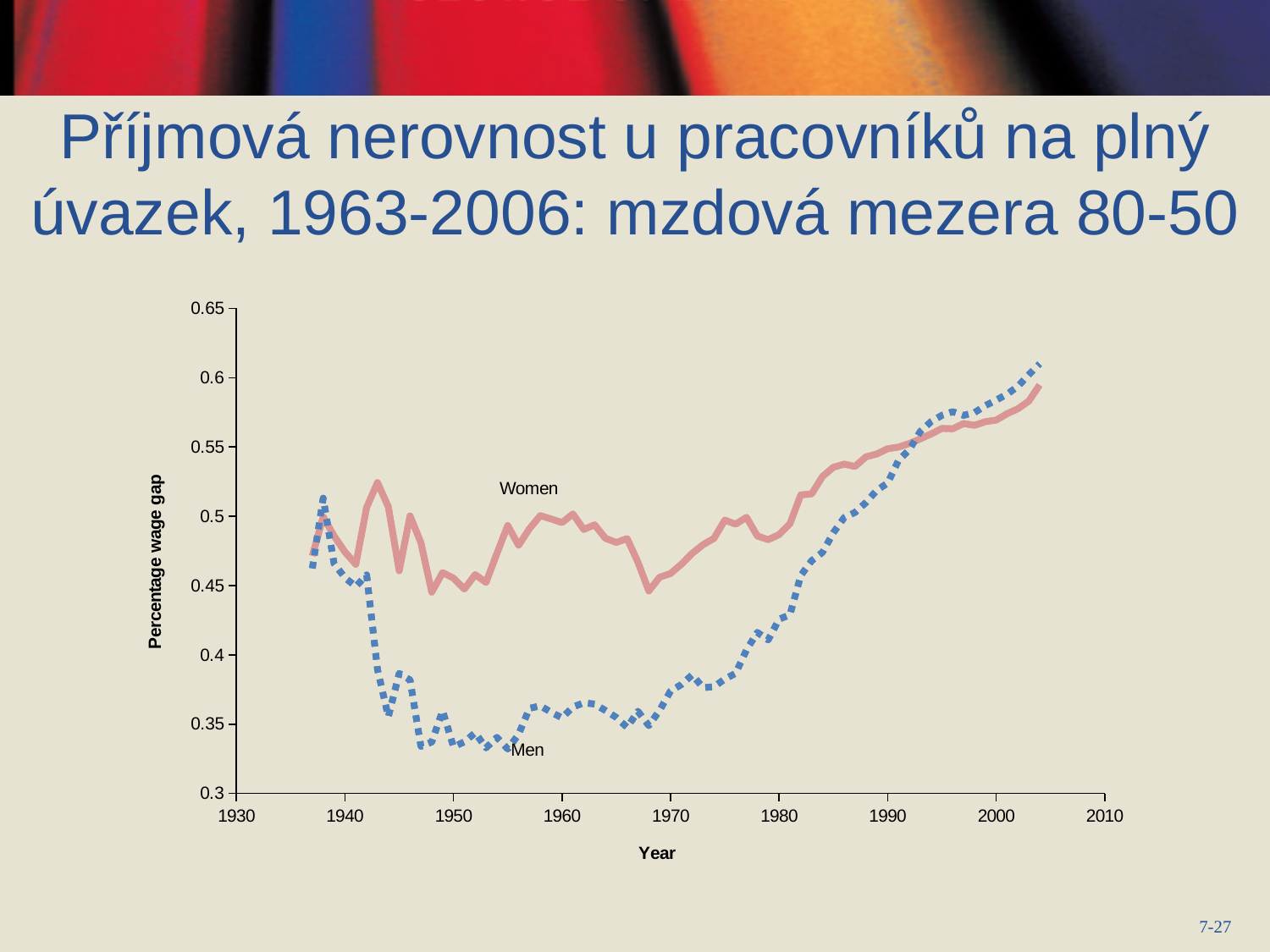
Around 1960, which series has the higher value, Women or Men? Women Which series is drawn as a dotted line? Men How many data series are plotted on the chart? 2 Around 1970, which series has the higher value, Women or Men? Women What is the title of the x axis? Year What kind of chart is shown on the slide? line chart Does the Men series rise or fall between 1940 and 1950? fall Is the value for Men around 1980 greater or less than 0.45? less Is the value for Women around 1985 greater or less than 0.5? greater Is the value for Women around 1940 greater or less than 0.45? greater Does the Men series rise or fall between 1980 and 2000? rise